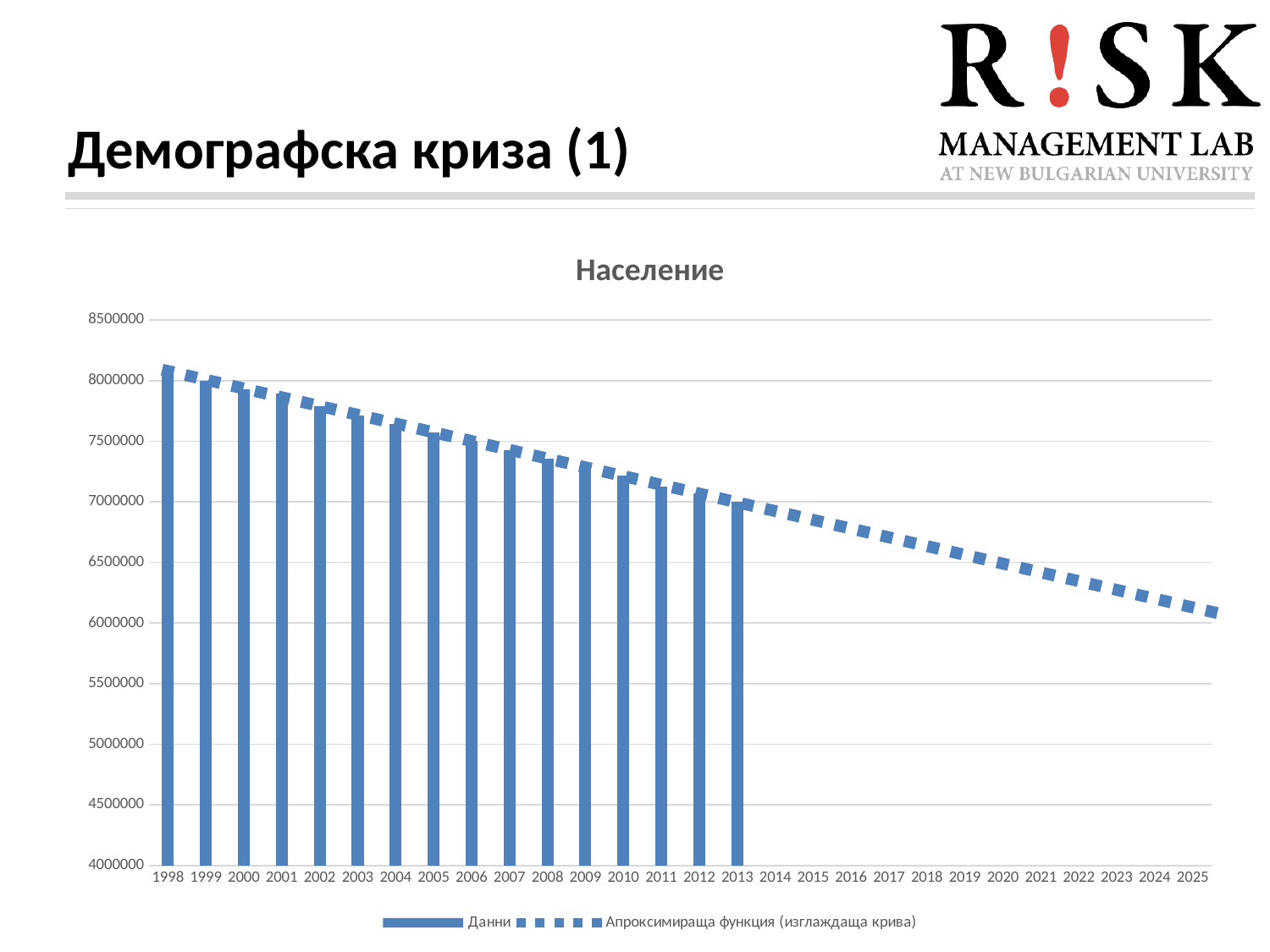
Which year has the lowest bar? 2013 Which year has the highest bar? 1998 How many series does the legend list? 2 Is the value for 2008 greater or less than 7500000? less Is the value for 1998 greater or less than 8000000? greater What are the two legend entries of the chart? Данни; Апроксимираща функция (изглаждаща крива) Do the bar values rise or fall from 1998 to 2013? fall What is the title of the chart? Население How many years are labelled on the x axis? 28 How many years have a bar plotted in the chart? 16 What kind of chart is shown on the slide? bar chart Is the value for 2010 greater or less than 7000000? greater